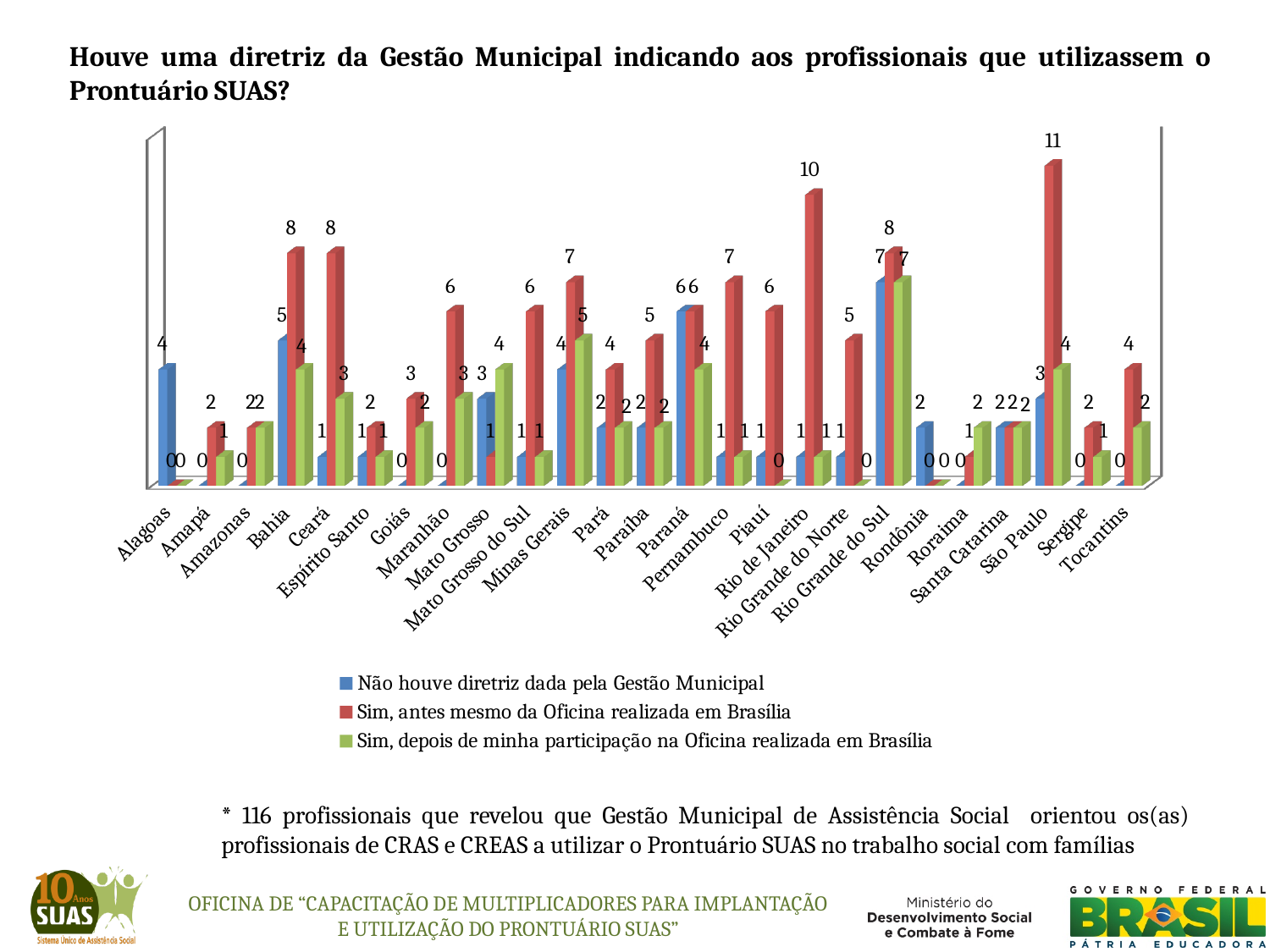
Which state has the highest value in the series 'Não houve diretriz dada pela Gestão Municipal'? Rio Grande do Sul What is the value for Alagoas in the series 'Não houve diretriz dada pela Gestão Municipal'? 4 What kind of chart is shown on the slide? bar chart How many states (categories) are shown on the x axis? 25 Which is larger for Bahia: the 'Não houve diretriz' value or the 'Sim, antes mesmo da Oficina' value? Sim, antes mesmo da Oficina realizada em Brasília What is the value for Minas Gerais in the series 'Sim, depois de minha participação na Oficina realizada em Brasília'? 5 Which series is shown in green in the legend? Sim, depois de minha participação na Oficina realizada em Brasília What is the difference between the 'Sim, antes mesmo da Oficina' values for São Paulo and Rio de Janeiro? 1 Which state has the highest value in the series 'Sim, antes mesmo da Oficina realizada em Brasília'? São Paulo What is the value for Rio de Janeiro in the series 'Sim, antes mesmo da Oficina realizada em Brasília'? 10 What is the value for São Paulo in the series 'Sim, antes mesmo da Oficina realizada em Brasília'? 11 How many series does the legend list? 3